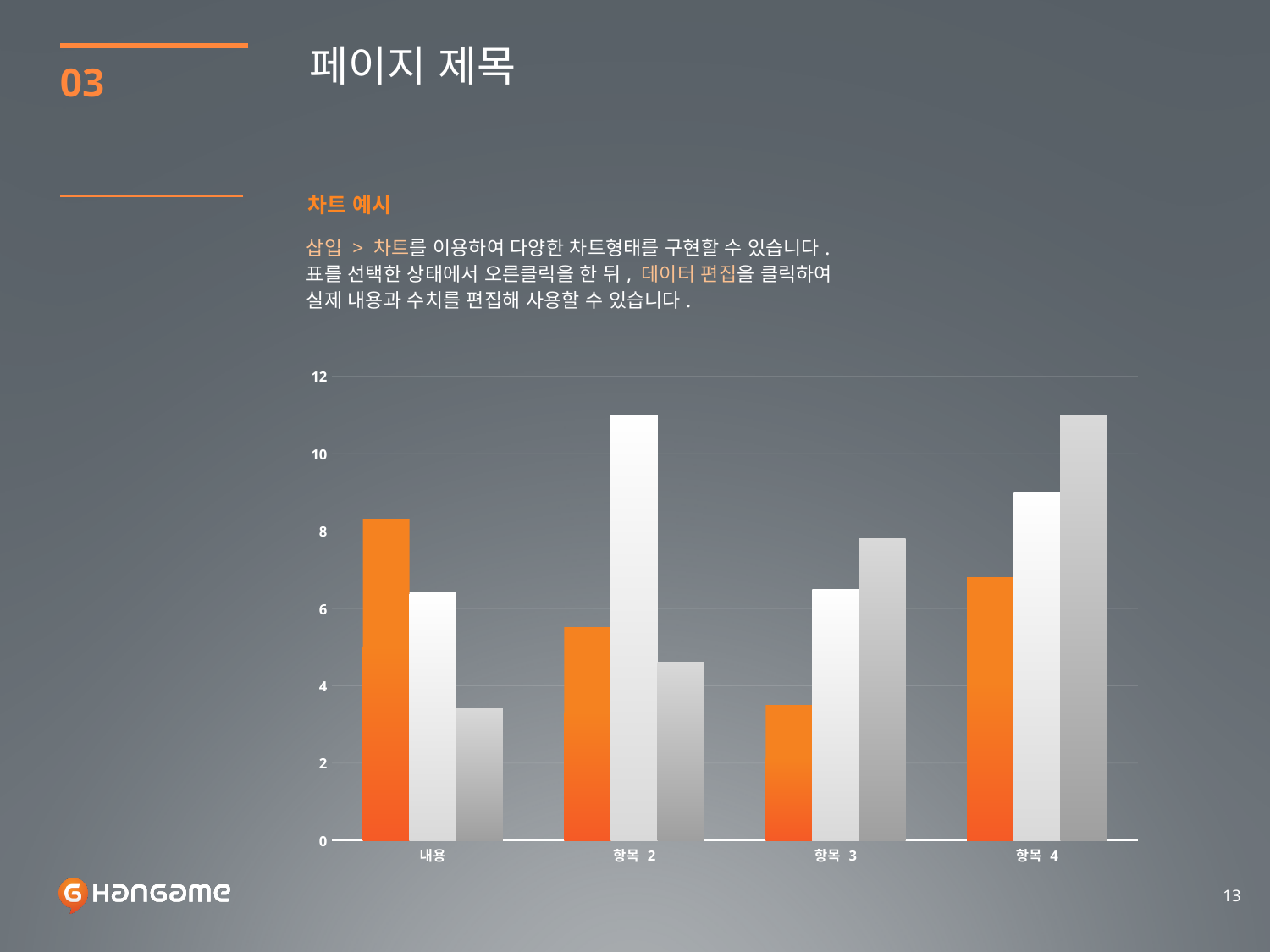
Which category has the lowest gray bar? 내용 What is the highest value shown on the vertical axis of the chart? 12 Is the value of the orange bar for 내용 greater or less than 8? greater How many categories are shown on the x axis of the chart? 4 Is the value of the orange bar for 항목 3 greater or less than 4? less Is the value of the white bar for 항목 2 greater or less than 10? greater For 항목 4, which is larger: the orange bar or the gray bar? the gray bar What kind of chart is shown on the slide? bar chart Which category has the highest orange bar? 내용 Which category has the lowest orange bar? 항목 3 How many bars are plotted for each category in the chart? 3